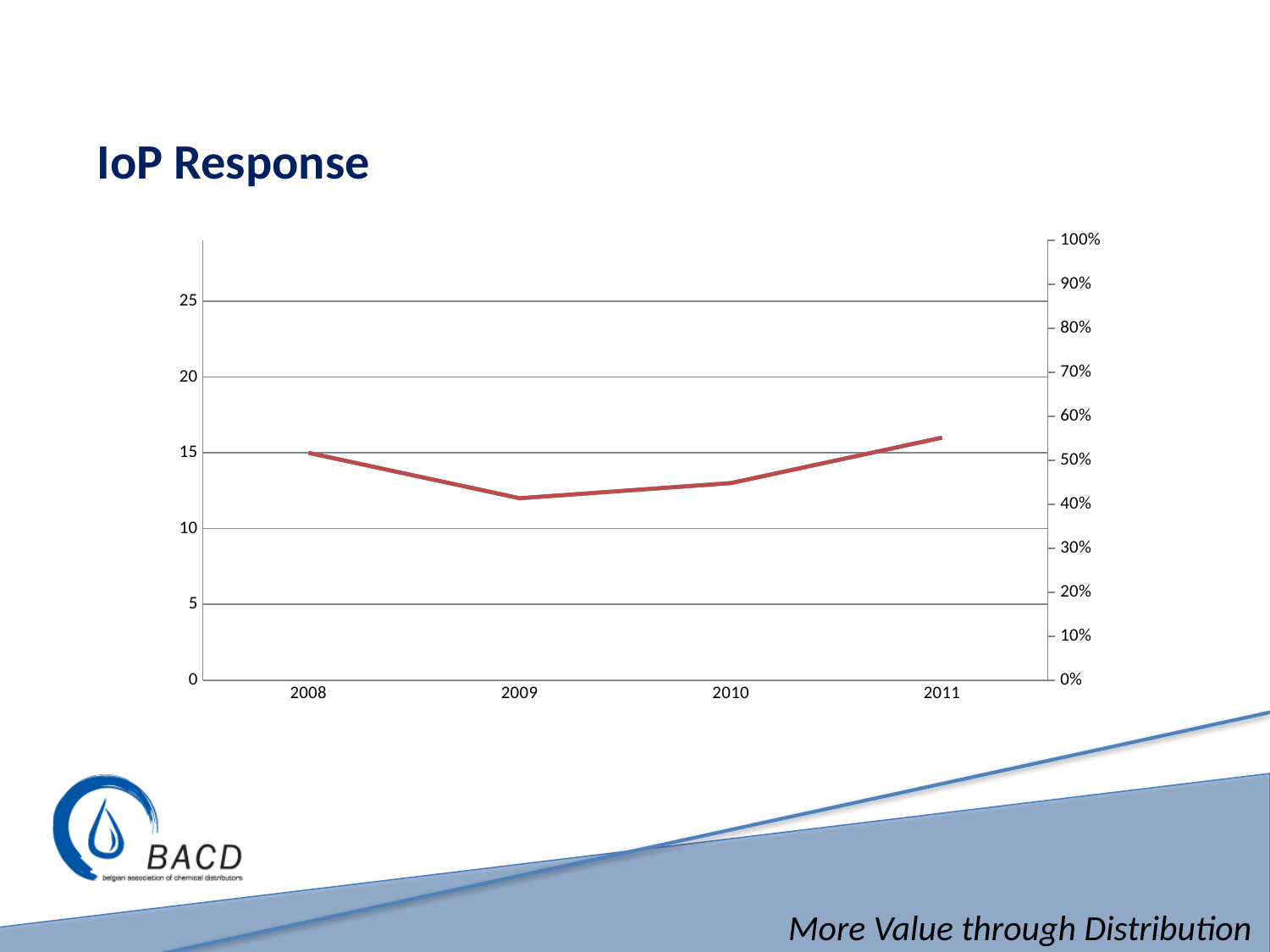
Does the line rise or fall from 2009 to 2011? rise On the left axis scale, is the value for 2010 greater or less than 10? greater Which is larger, the value for 2010 or the value for 2011? 2011 What kind of chart is shown on the slide? line chart On the left axis scale, is the value for 2011 greater or less than 15? greater On the left axis scale, is the value for 2009 greater or less than 15? less Which year has the highest value on the line? 2011 How many years are plotted along the x axis of the chart? 4 Which year has the lowest value on the line? 2009 What is the title shown above the chart on the slide? IoP Response Which is larger, the value for 2008 or the value for 2009? 2008 Does the line rise or fall from 2008 to 2009? fall